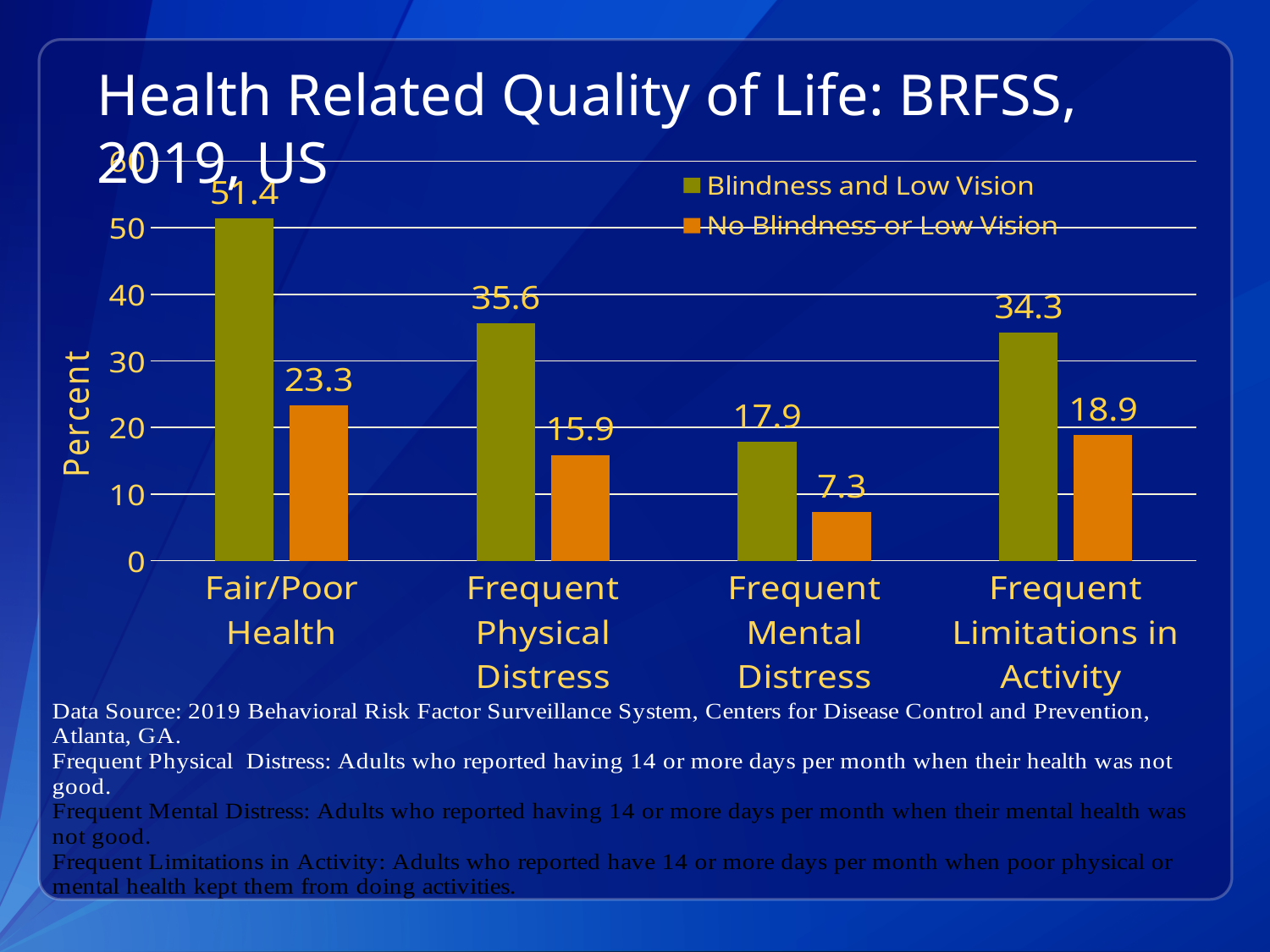
What is the value for No Blindness or Low Vision in the Frequent Limitations in Activity category? 18.9 What is the value for Blindness and Low Vision in the Frequent Physical Distress category? 35.6 What is the label of the y axis? Percent Which category has the highest value for Blindness and Low Vision? Fair/Poor Health Which is larger for Frequent Limitations in Activity: Blindness and Low Vision or No Blindness or Low Vision? Blindness and Low Vision What kind of chart is shown on the slide? Bar chart What is the value for Blindness and Low Vision in the Fair/Poor Health category? 51.4 How many series does the legend list? 2 What is the difference between the Blindness and Low Vision and No Blindness or Low Vision values for Fair/Poor Health? 28.1 Which category has the lowest value for No Blindness or Low Vision? Frequent Mental Distress What is the value for No Blindness or Low Vision in the Frequent Mental Distress category? 7.3 How many categories are shown on the x axis? 4